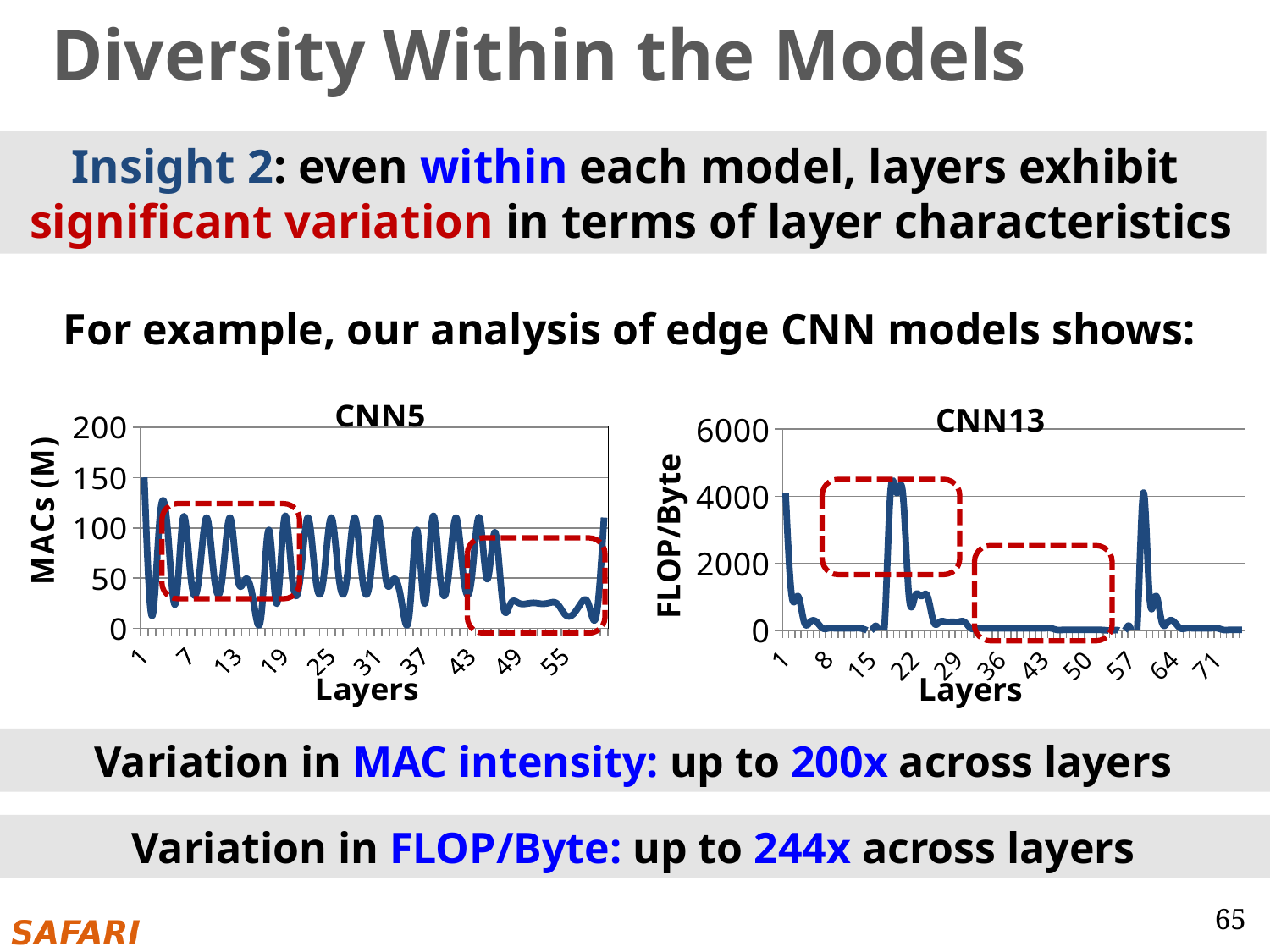
In the CNN13 chart, which is larger, the value for layer 1 or the value for layer 43? Layer 1 In the CNN5 chart, is the value for layer 1 greater or less than 100? greater What is the highest tick value on the y axis of the CNN13 chart? 6000 In the CNN13 chart, is the value for layer 43 greater or less than 2000? less How many labelled ticks are on the x axis of the CNN13 chart? 11 In the CNN13 chart, do the values rise or fall from layer 1 to layer 8? fall In the CNN5 chart, is the value for layer 55 greater or less than 50? less What kind of chart is the CNN13 chart on the right? Line chart What kind of chart is the CNN5 chart on the left? Line chart What is the y-axis label of the CNN5 chart? MACs (M) In the CNN5 chart, which is larger, the value for layer 1 or the value for layer 55? Layer 1